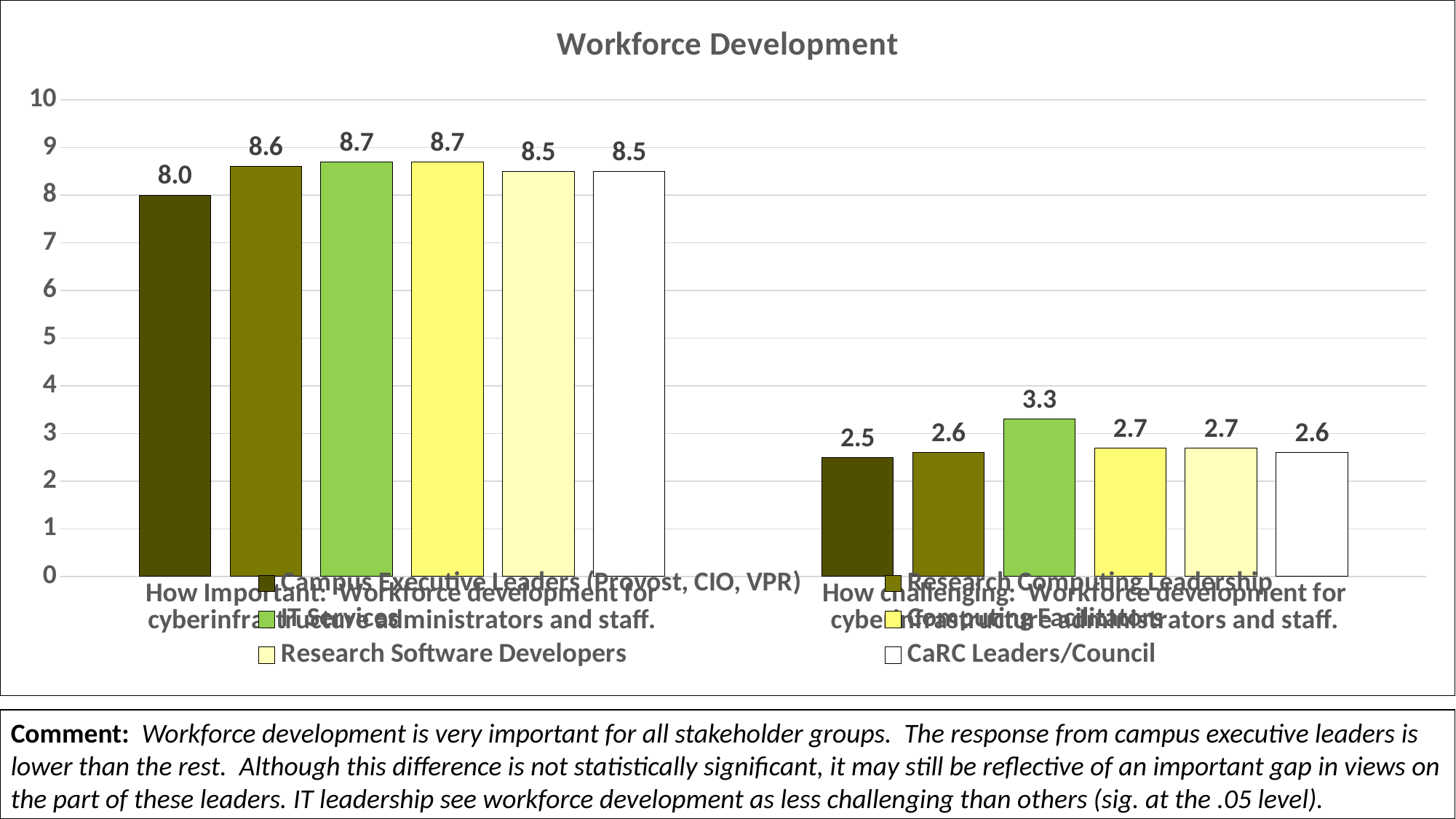
How many category groups are shown on the x axis? 2 Which is larger in the 'How Important' group: the value for IT Services or the value for Campus Executive Leaders (Provost, CIO, VPR)? IT Services What is the value for IT Services in the 'How challenging' group? 3.3 Which series has the lowest value in the 'How Important' group? Campus Executive Leaders (Provost, CIO, VPR) What is the value for CaRC Leaders/Council in the 'How challenging' group? 2.6 What is the title of the chart? Workforce Development What kind of chart is shown on the slide? bar chart How many series does the legend list? 6 What is the difference between the IT Services value and the Campus Executive Leaders value in the 'How challenging' group? 0.8 What is the value for Research Computing Leadership in the 'How Important' group? 8.6 Which series has the highest value in the 'How challenging' group? IT Services What is the value for Campus Executive Leaders (Provost, CIO, VPR) in the 'How Important' group? 8.0